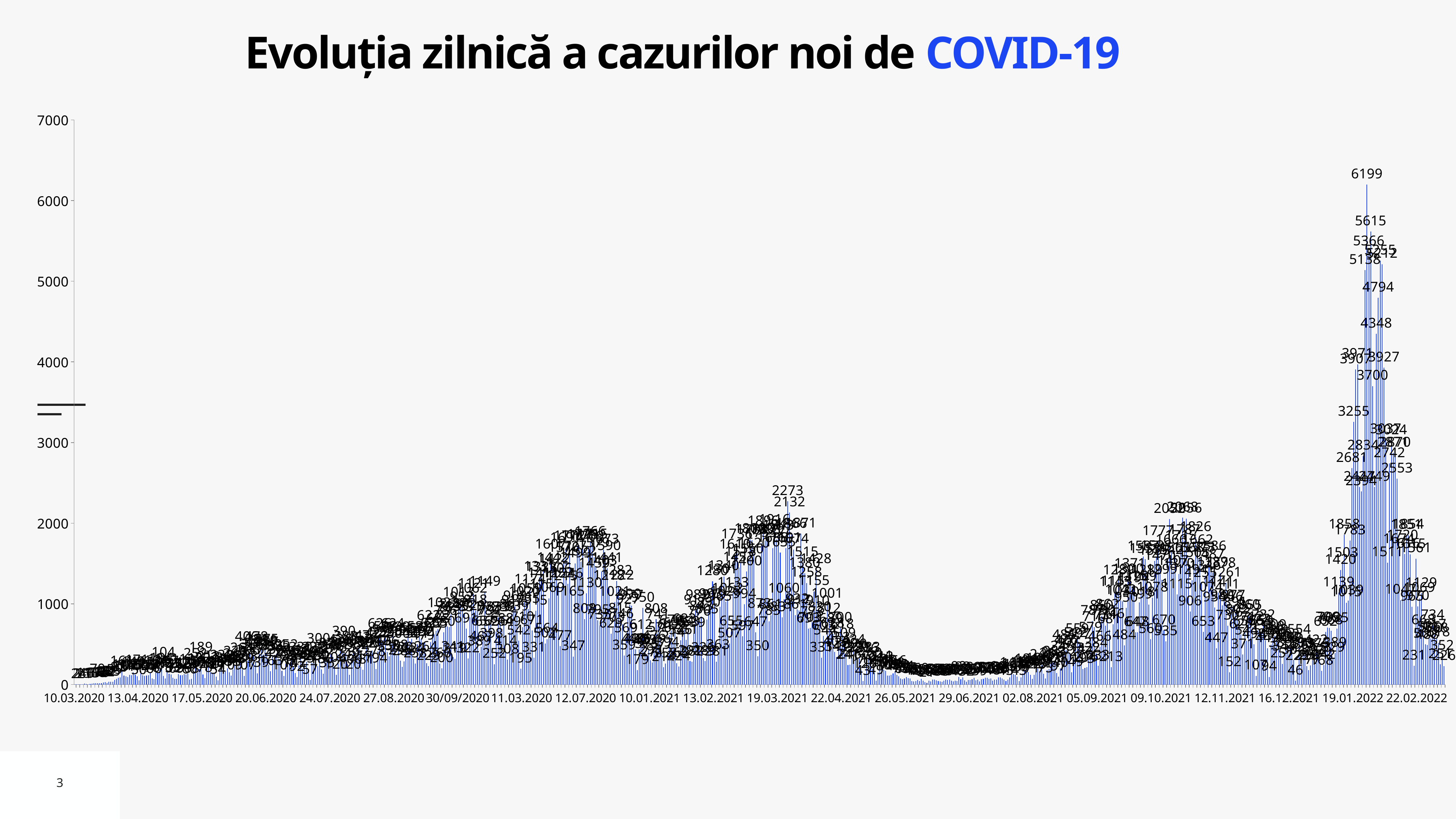
What is the title of the chart? Evoluția zilnică a cazurilor noi de COVID-19 What kind of chart is shown on the slide? bar chart Do the values rise or fall between the peak near 19.01.2022 and the end of the chart at 22.02.2022? fall Is the highest peak on the chart greater or less than 6000? greater What is the difference between the two highest labeled values, 6199 and 5615? 584 What is the highest labeled value in the wave around 19.03.2021? 2273 Which is larger: the peak of the wave around 19.03.2021 (2273) or the peak of the wave around 19.01.2022 (6199)? 6199 What is the first date shown on the horizontal axis? 10.03.2020 What is the maximum value shown on the vertical axis? 7000 What is the last date shown on the horizontal axis? 22.02.2022 Is the peak of the wave around 19.03.2021 greater or less than 3000? less What is the highest daily value labeled on the chart? 6199